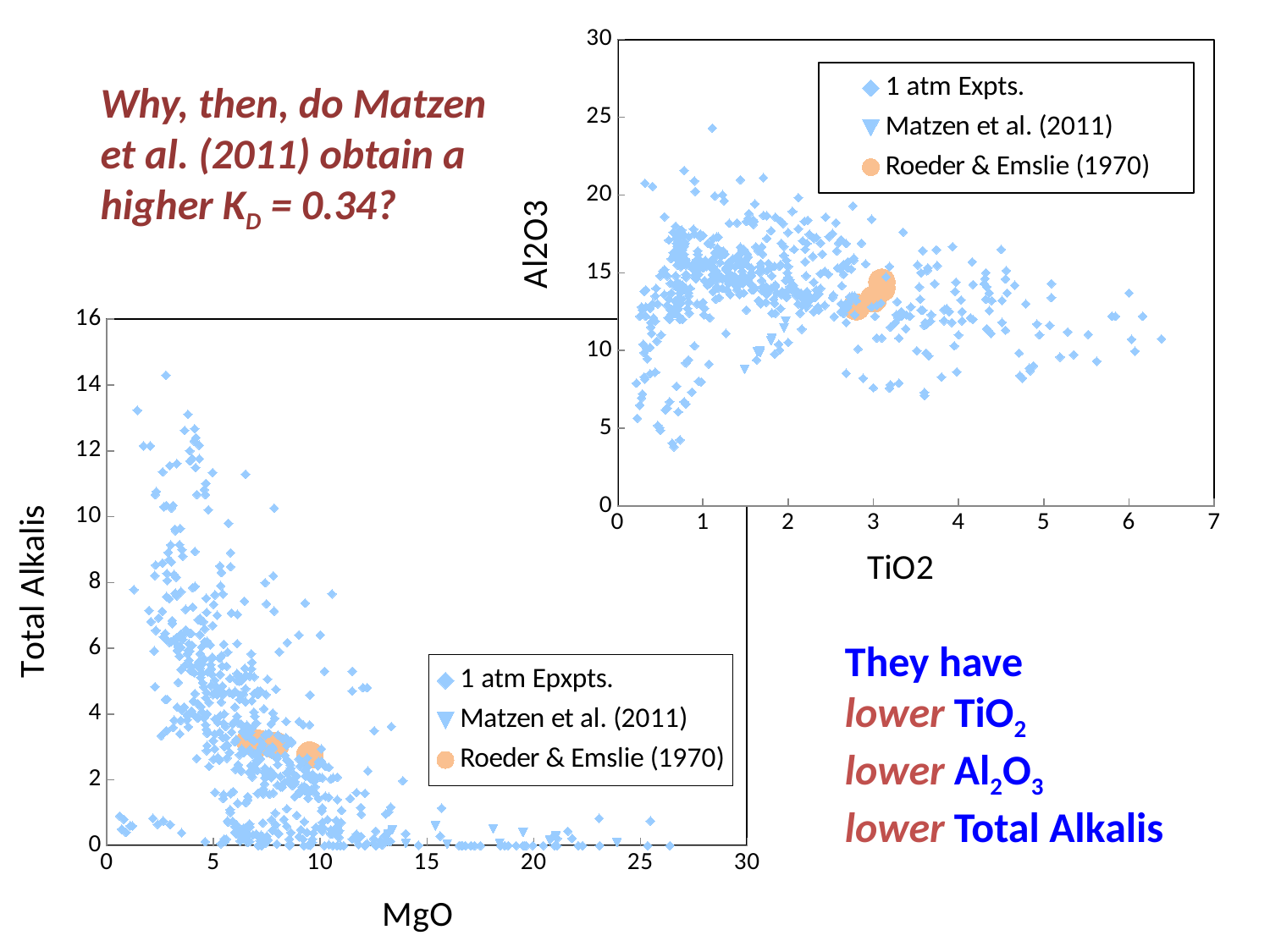
In the chart with MgO on the x axis, do the Total Alkalis values generally rise or fall as MgO increases? Fall What kind of chart is the chart on the left with MgO on the x axis? Scatter chart In the chart with MgO on the x axis, what is the label of the y axis? Total Alkalis In the chart with TiO2 on the x axis, what is the label of the y axis? Al2O3 In the chart with MgO on the x axis, is the Total Alkalis value of the Roeder & Emslie (1970) cluster greater or less than 6? less In the chart with MgO on the x axis, is the MgO value of the Roeder & Emslie (1970) cluster greater or less than 15? less In the chart with TiO2 on the x axis, how many series does the legend list? 3 In the chart with TiO2 on the x axis, is the TiO2 value of the Roeder & Emslie (1970) cluster greater or less than 2? greater In the chart with MgO on the x axis, how many series does the legend list? 3 What kind of chart is the chart on the right with TiO2 on the x axis? Scatter chart In the chart with TiO2 on the x axis, what is the maximum value shown on the x axis? 7